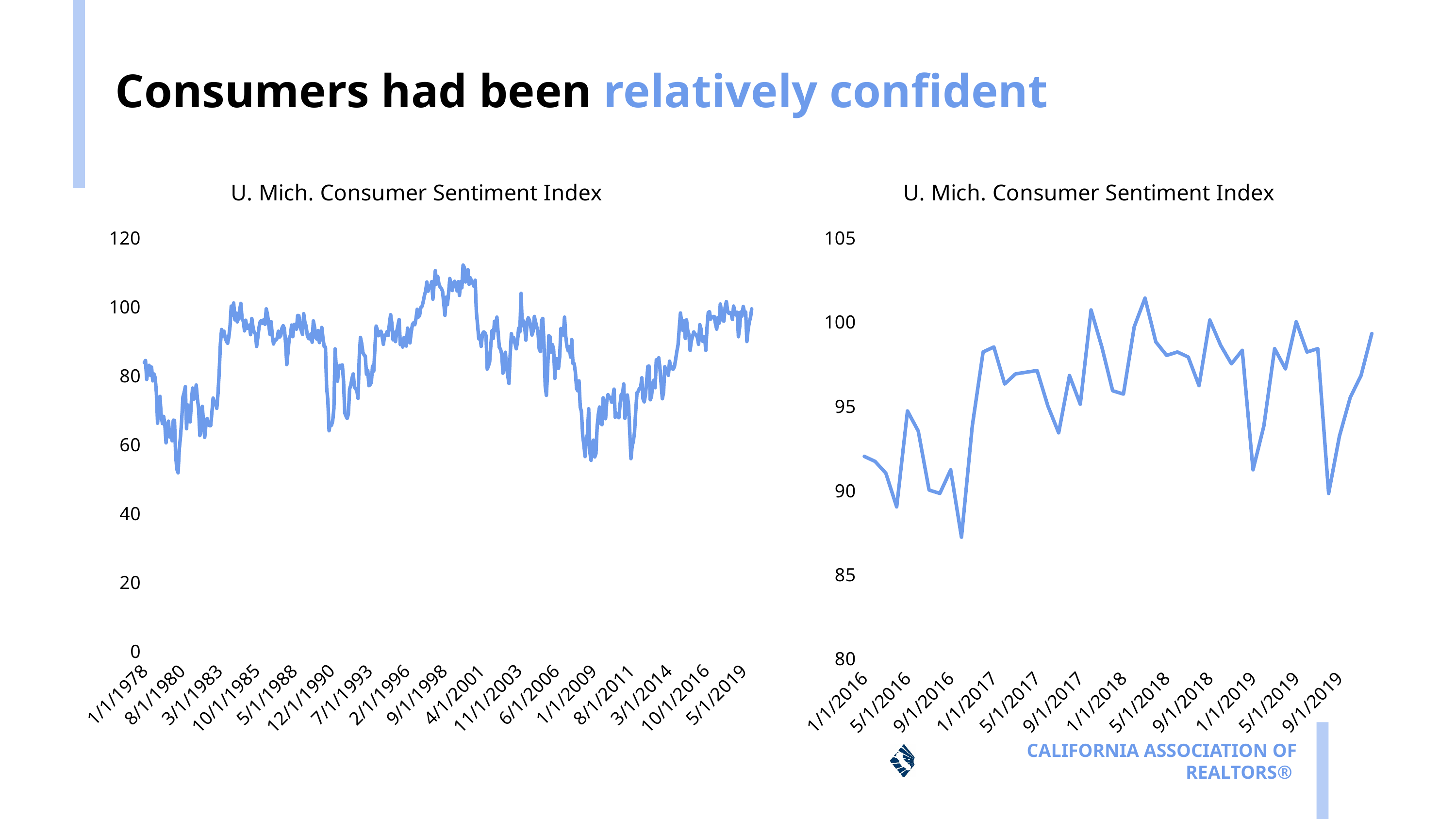
What is the highest value shown on the y axis of the right chart? 105 In the right chart, is the value at 1/1/2017 greater or less than 95? greater In the left chart, is the value at 1/1/1978 greater or less than 100? less What kind of chart is the right chart titled 'U. Mich. Consumer Sentiment Index'? line chart In the left chart, is the value around 1/1/2009 greater or less than 80? less What kind of chart is the left chart titled 'U. Mich. Consumer Sentiment Index'? line chart In the right chart, does the index overall rise or fall from 1/1/2016 to 9/1/2019? rise What is the title of the left chart? U. Mich. Consumer Sentiment Index